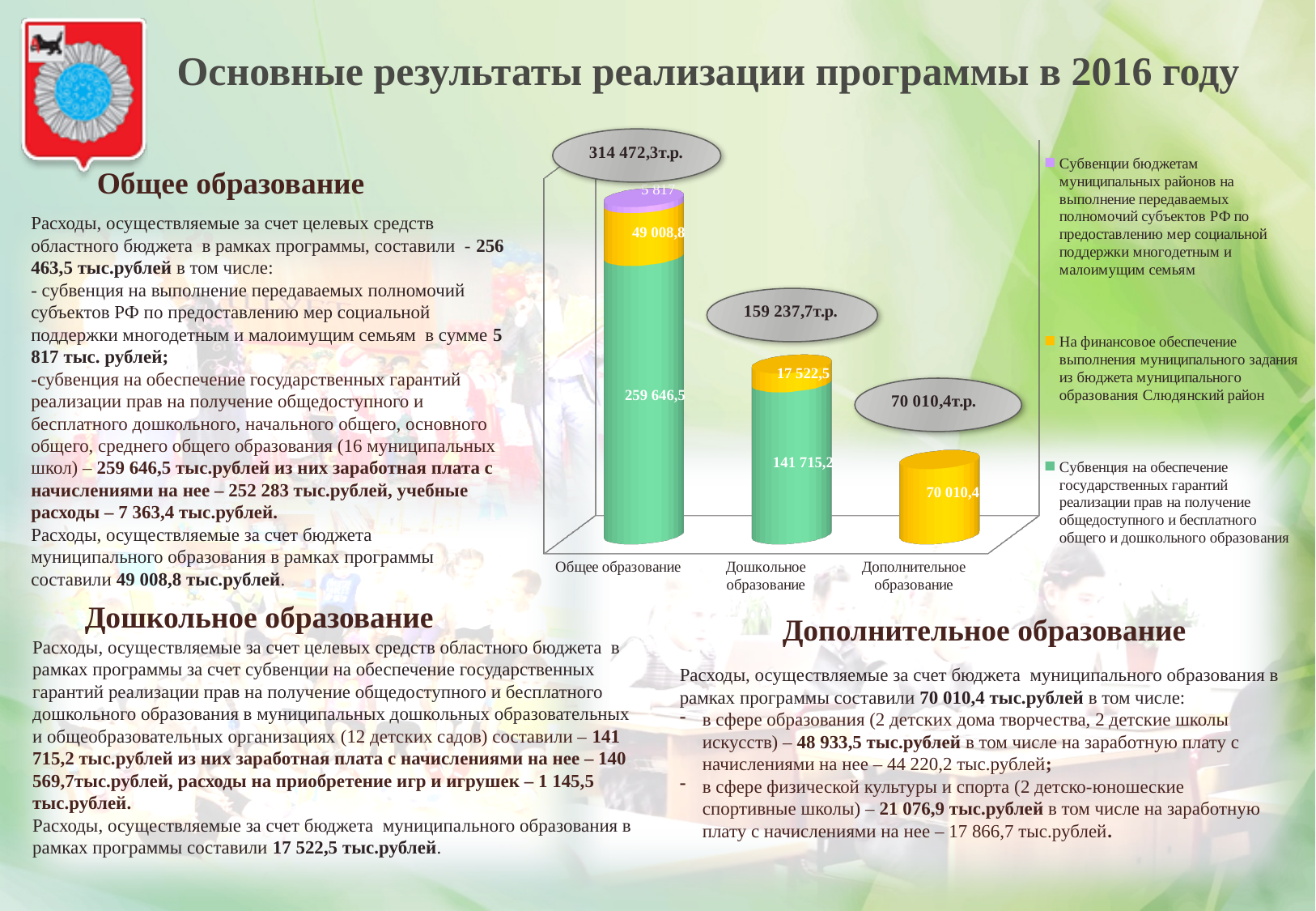
What is the total value shown above the bar for Дополнительное образование? 70 010,4т.р. What is the value of the purple segment (Субвенции бюджетам муниципальных районов) for Общее образование? 5 817 What is the value of the yellow segment (На финансовое обеспечение выполнения муниципального задания) for Дошкольное образование? 17 522,5 Which is larger: the green segment for Общее образование or the green segment for Дошкольное образование? Общее образование What kind of chart is shown on the slide? bar chart Which category has the highest total bar? Общее образование Which category has the lowest total bar? Дополнительное образование What is the value of the green segment (Субвенция на обеспечение государственных гарантий) for Общее образование? 259 646,5 How many series does the chart legend list? 3 How many categories are shown on the x axis of the chart? 3 What is the total value shown above the bar for Общее образование? 314 472,3т.р. What is the total value shown above the bar for Дошкольное образование? 159 237,7т.р.